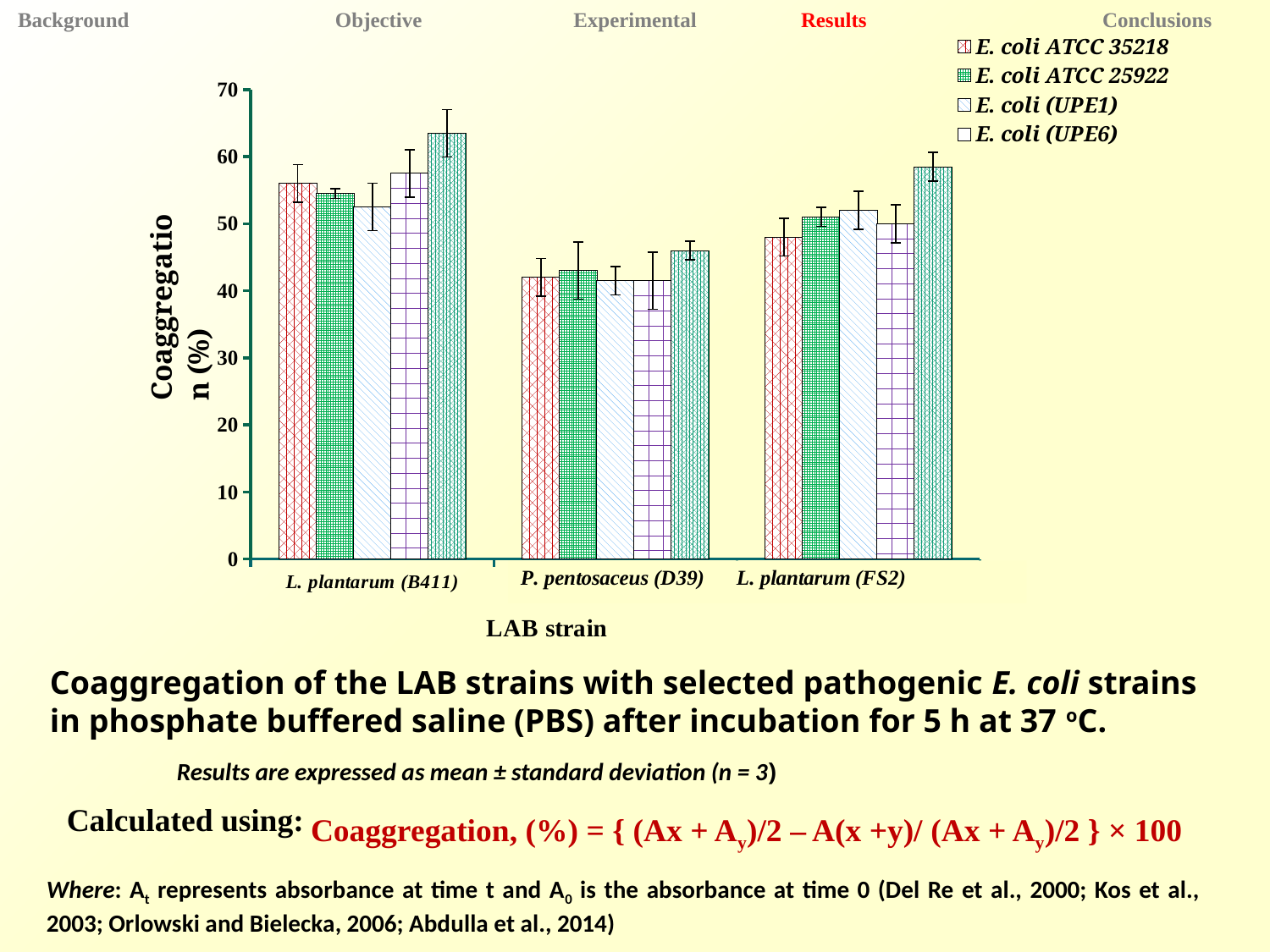
What is the title of the x axis of the chart? LAB strain Is the coaggregation value for E. coli (UPE1) with L. plantarum (FS2) greater or less than 40? greater How many LAB strains are shown on the x axis of the chart? 3 Is the coaggregation value for E. coli ATCC 35218 with P. pentosaceus (D39) greater or less than 50? less How many E. coli strains does the chart legend list? 4 Is the coaggregation value for E. coli (UPE6) with L. plantarum (B411) greater or less than 50? greater Which LAB strain has the highest coaggregation value with E. coli ATCC 35218? L. plantarum (B411) What kind of chart is shown on the slide? bar chart Which LAB strain has the lowest coaggregation value with E. coli (UPE6)? P. pentosaceus (D39) Which has the larger coaggregation value with E. coli (UPE1): L. plantarum (FS2) or P. pentosaceus (D39)? L. plantarum (FS2) What is the title of the y axis of the chart? Coaggregation (%)